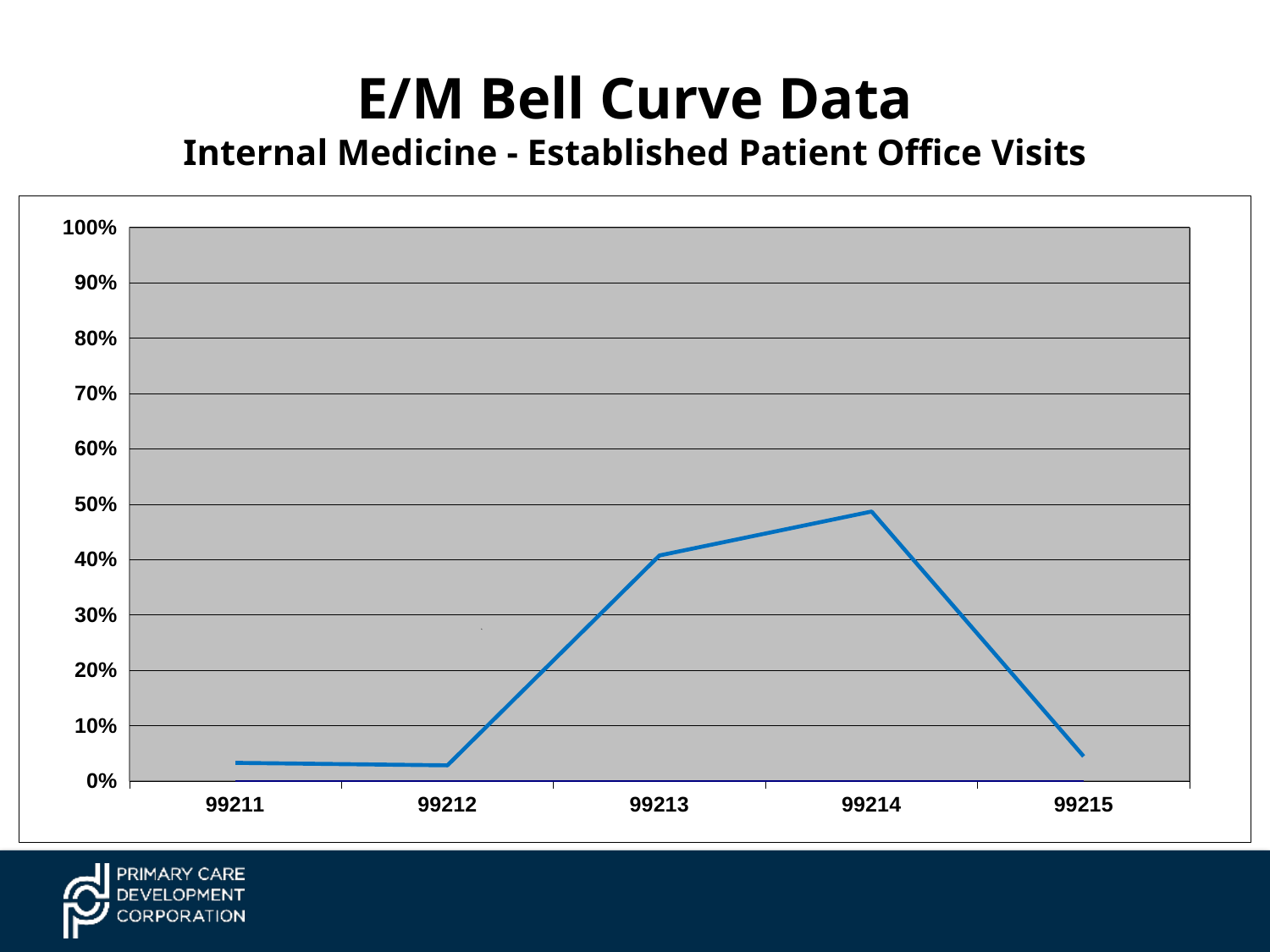
What is the subtitle of the chart shown on the slide? Internal Medicine - Established Patient Office Visits Is the value for 99211 greater or less than 10%? less Which is larger, the value for 99213 or the value for 99214? 99214 What kind of chart is shown on the slide? line chart Does the line rise or fall between 99214 and 99215? fall Is the value for 99215 greater or less than 10%? less Is the value for 99212 greater or less than 20%? less Which is larger, the value for 99213 or the value for 99215? 99213 How many categories are plotted along the x axis? 5 Which category has the highest value? 99214